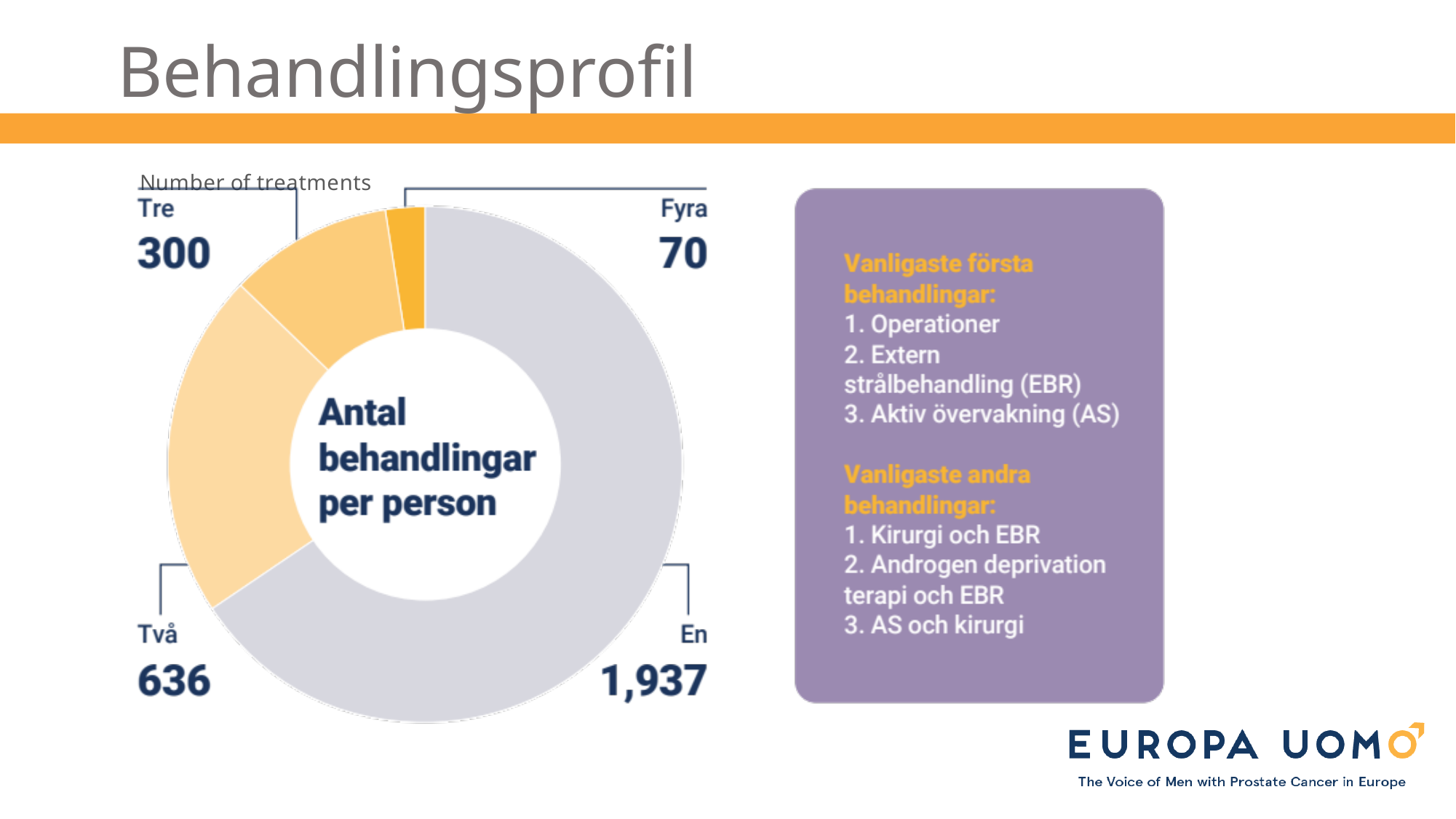
What kind of chart is shown on the slide? Pie chart (donut) What is the difference between the values for Två and Tre? 336 What is the value shown for Fyra (four treatments)? 70 Which category has the largest value in the chart? En Which category has the smallest value in the chart? Fyra What is the value shown for Två (two treatments)? 636 What is the difference between the values for En and Två? 1,301 What is the value shown for Tre (three treatments)? 300 How many people had one treatment (En) according to the chart? 1,937 Which is larger, the value for Tre or the value for Fyra? Tre What text is written in the centre of the chart? Antal behandlingar per person How many categories does the chart show? 4